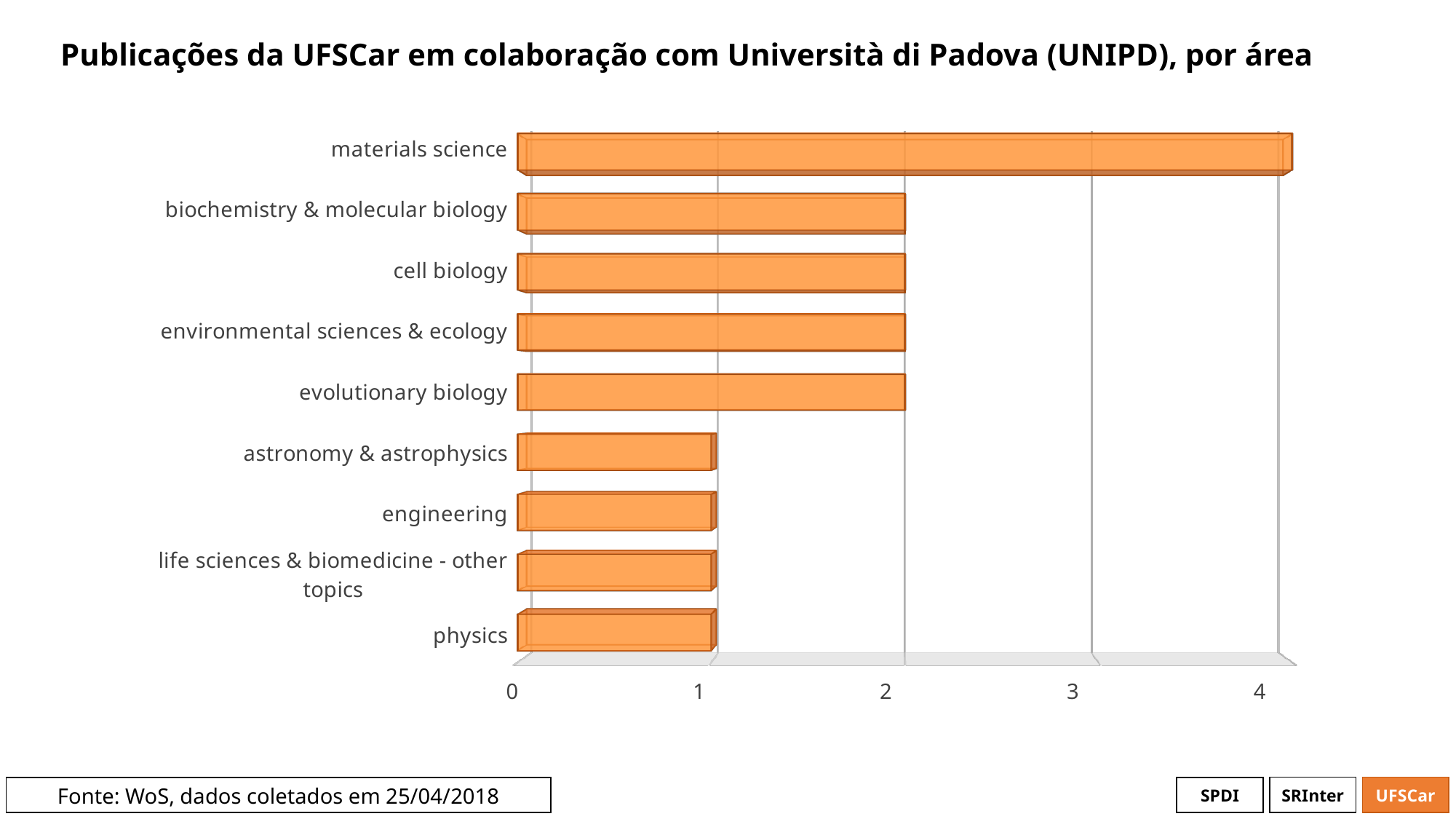
What is the title of the chart? Publicações da UFSCar em colaboração com Università di Padova (UNIPD), por área How many publications are shown for engineering? 1 How many publications are shown for physics? 1 What kind of chart is shown on the slide? bar chart Which area has the highest number of publications? materials science How many publications are shown for materials science? 4 Is the value for materials science greater or less than 3? greater How many areas (categories) are shown in the chart? 9 How many publications are shown for cell biology? 2 What is the difference between the number of publications for materials science and for biochemistry & molecular biology? 2 Is the value for environmental sciences & ecology greater or less than 1? greater Which has more publications, evolutionary biology or astronomy & astrophysics? evolutionary biology